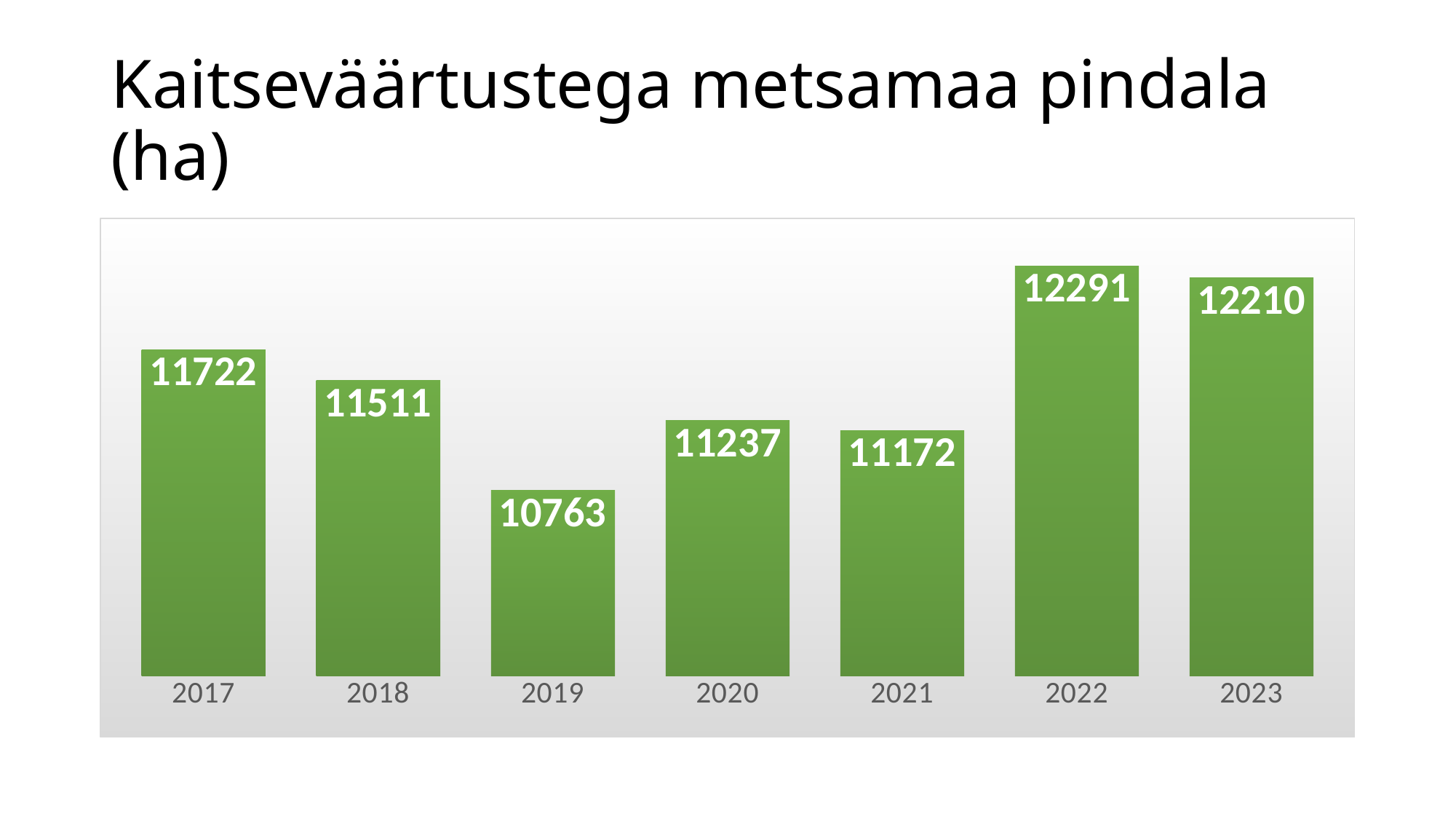
Which year has the lowest value? 2019 What kind of chart is shown on the slide? bar chart What is the value for 2017? 11722 What is the difference between the values for 2022 and 2023? 81 What is the value for 2021? 11172 What is the value for 2019? 10763 What is the title of the slide? Kaitseväärtustega metsamaa pindala (ha) Which year has the highest value? 2022 Which is larger, the value for 2020 or the value for 2021? 2020 What is the value for 2023? 12210 How many years are shown on the x axis? 7 What is the difference between the values for 2017 and 2018? 211